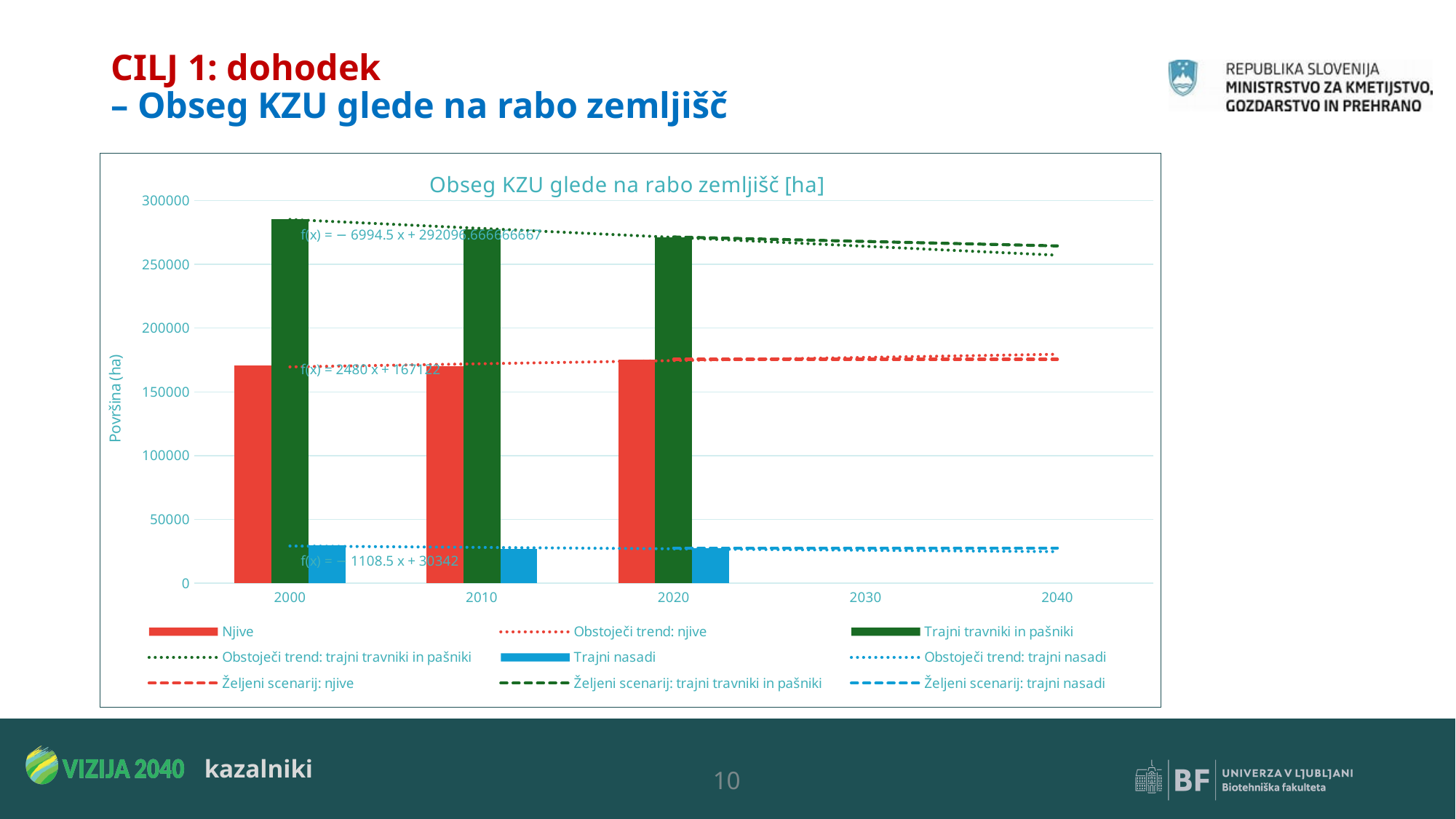
What kind of chart is shown on the slide? combination bar and line chart Which land-use category has the lowest bar in 2020? Trajni nasadi How many entries does the chart legend list? 9 In 2020, which is larger: the bar for Njive or the bar for Trajni travniki in pašniki? Trajni travniki in pašniki What is the label of the y axis? Površina (ha) Is the value for Njive in 2000 greater or less than 150000? greater Do the bars for Trajni travniki in pašniki rise or fall from 2000 to 2020? fall How many years are labelled on the x axis of the chart? 5 What is the title of the chart? Obseg KZU glede na rabo zemljišč [ha] Is the value for Trajni travniki in pašniki in 2000 greater or less than 250000? greater Is the value for Trajni nasadi in 2010 greater or less than 50000? less Which land-use category has the highest bar in 2010? Trajni travniki in pašniki